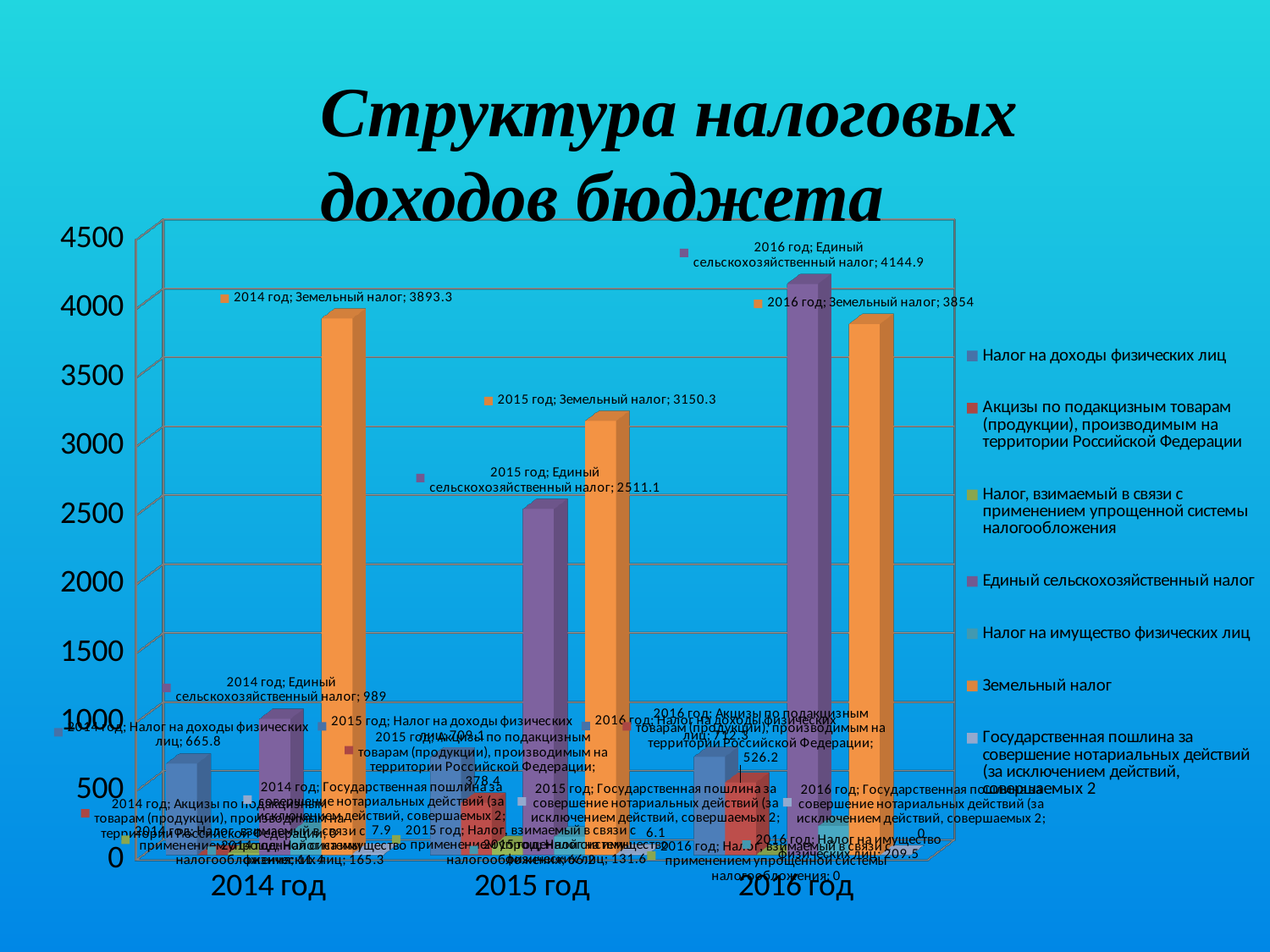
How many year categories are shown on the x axis? 3 Does Единый сельскохозяйственный налог rise or fall from 2014 год to 2016 год? rises What is the value of Земельный налог for 2015 год? 3150.3 What is the title of the slide? Структура налоговых доходов бюджета What kind of chart is shown on the slide? bar chart In which year is Земельный налог the highest? 2014 год What is the value of Единый сельскохозяйственный налог for 2015 год? 2511.1 What is the value of Земельный налог for 2014 год? 3893.3 What is the value of Единый сельскохозяйственный налог for 2016 год? 4144.9 What is the difference between Земельный налог in 2014 год and in 2016 год? 39.3 In 2016 год, which is larger: Единый сельскохозяйственный налог or Земельный налог? Единый сельскохозяйственный налог How many series does the legend list? 7